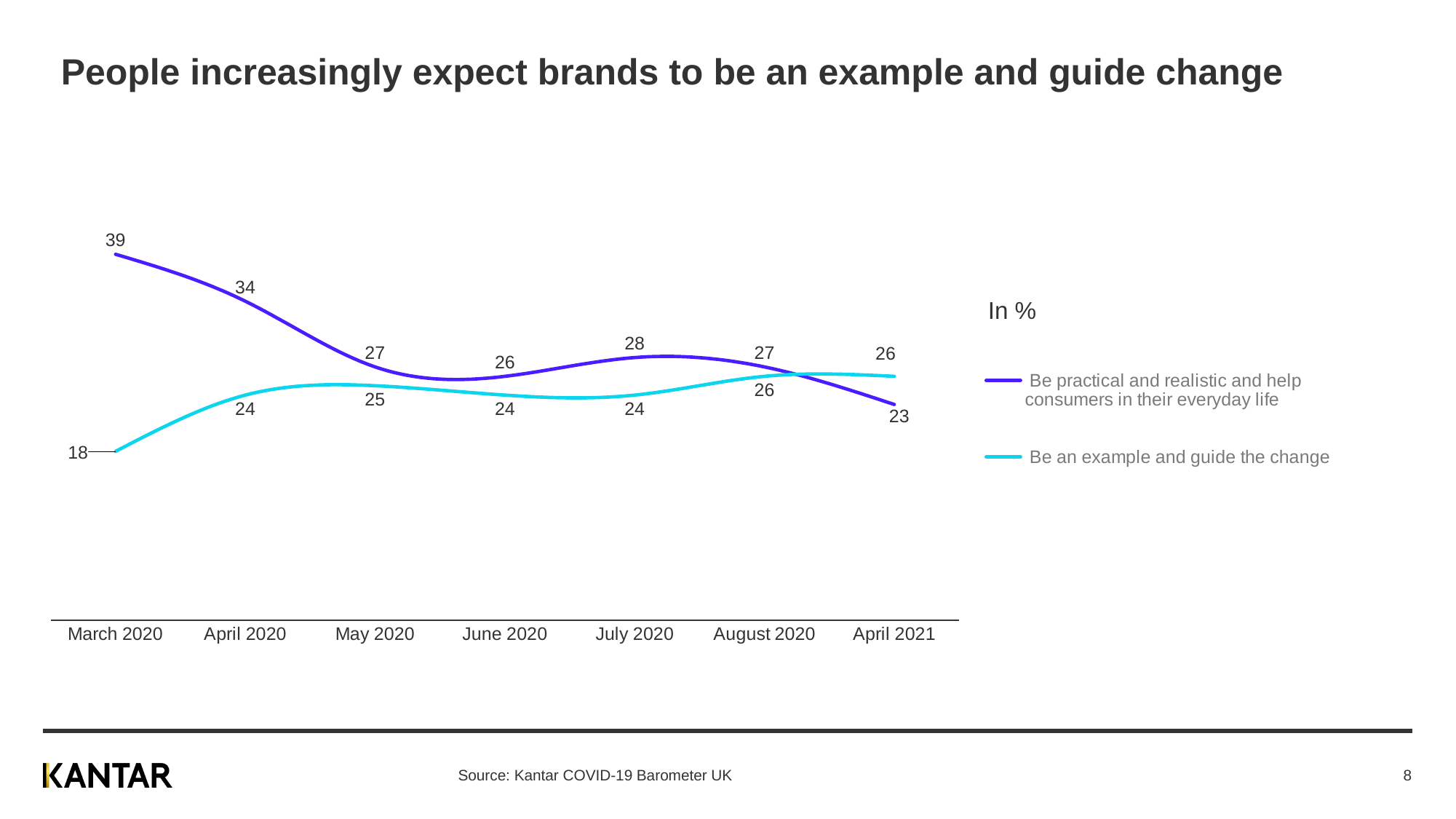
What is the value for 'Be practical and realistic and help consumers in their everyday life' in March 2020? 39 What kind of chart is shown on the slide? line chart What is the value for 'Be an example and guide the change' in March 2020? 18 In which month is the value for 'Be an example and guide the change' lowest? March 2020 What is the value for 'Be an example and guide the change' in April 2021? 26 Does the value for 'Be practical and realistic and help consumers in their everyday life' rise or fall from March 2020 to May 2020? fall How many time points are plotted along the x axis? 7 What is the difference between the two series in March 2020? 21 In which month is the value for 'Be practical and realistic and help consumers in their everyday life' highest? March 2020 How many series does the legend list? 2 What is the value for 'Be practical and realistic and help consumers in their everyday life' in July 2020? 28 In April 2021, which series has the higher value? Be an example and guide the change